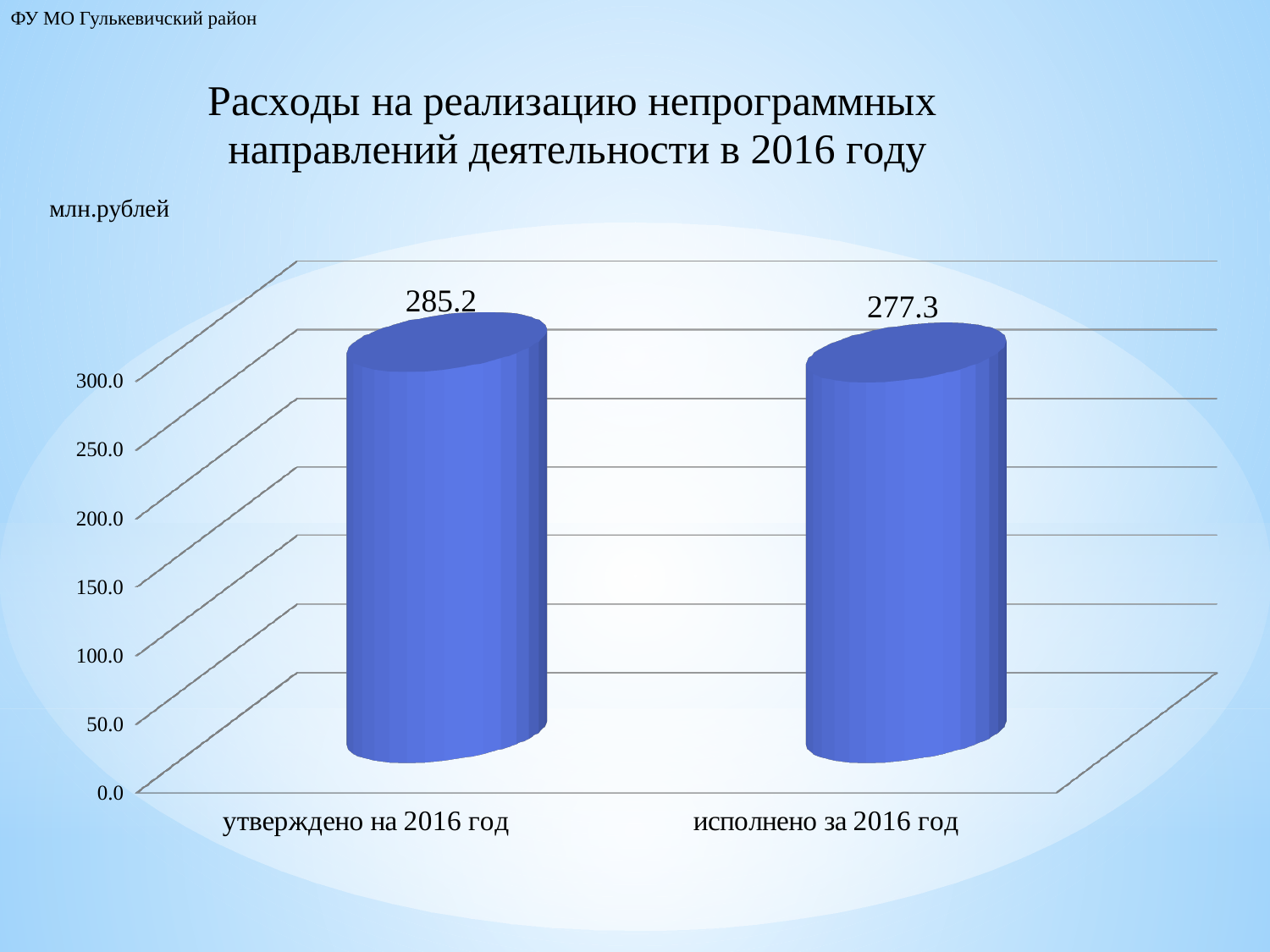
How many categories are shown on the chart? 2 What is the difference between the value for "утверждено на 2016 год" and the value for "исполнено за 2016 год"? 7.9 What unit of measurement is indicated above the chart? млн.рублей What is the value for "исполнено за 2016 год"? 277.3 Is the value for "утверждено на 2016 год" larger or smaller than the value for "исполнено за 2016 год"? larger What is the highest value shown on the vertical axis? 300.0 Is the value for "исполнено за 2016 год" greater or less than 250.0? greater What is the value for "утверждено на 2016 год"? 285.2 Which category has the higher value? утверждено на 2016 год What is the title of the chart? Расходы на реализацию непрограммных направлений деятельности в 2016 году Which category has the lower value? исполнено за 2016 год What kind of chart is shown on the slide? bar chart